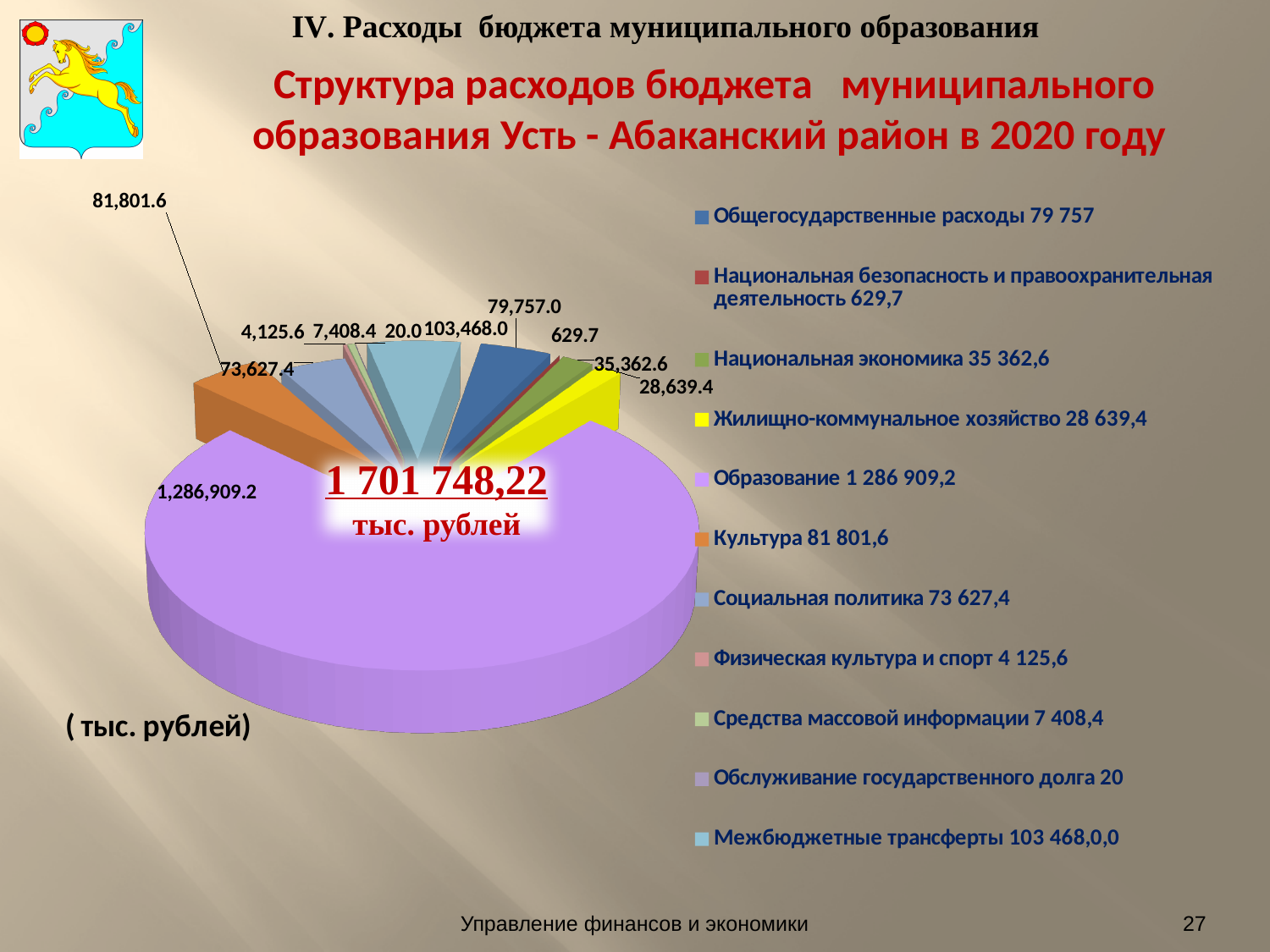
What is the value shown for Культура on the pie chart? 81,801.6 What is the value shown for Образование on the pie chart? 1,286,909.2 What colour is the slice for Жилищно-коммунальное хозяйство? yellow What type of chart is shown on the slide? pie chart What is the value shown for Обслуживание государственного долга on the pie chart? 20.0 Which category has the largest slice of the pie chart? Образование What total amount is printed in the centre of the pie chart? 1 701 748,22 тыс. рублей How many categories does the pie chart have? 11 Which category has the smallest slice of the pie chart? Обслуживание государственного долга What is the difference between the values for Культура and Социальная политика? 8,174.2 What is the value shown for Межбюджетные трансферты on the pie chart? 103,468.0 Which is larger, the value for Национальная экономика or the value for Жилищно-коммунальное хозяйство? Национальная экономика